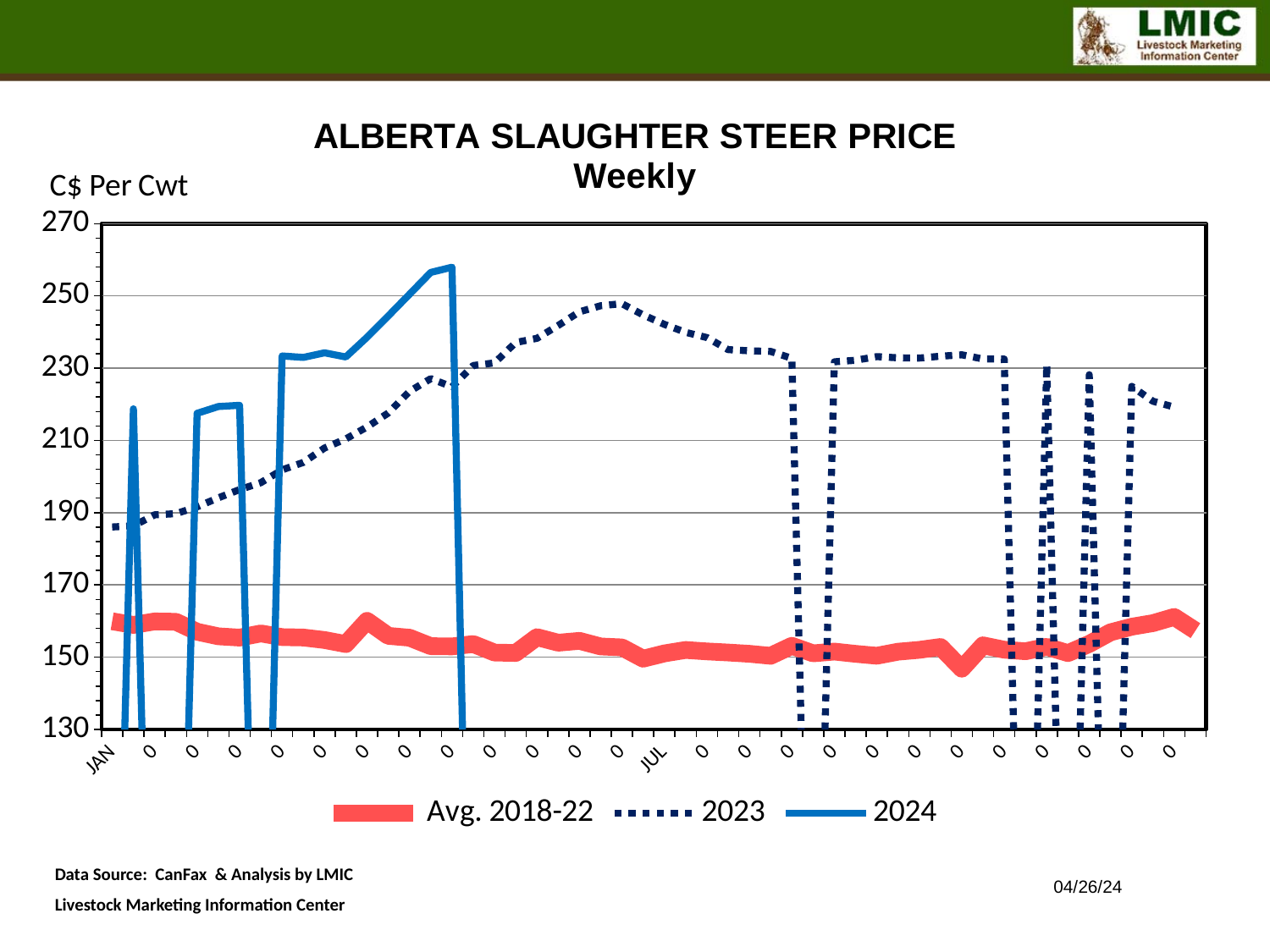
At JAN, which is higher: the 2023 line or the Avg. 2018-22 line? 2023 Is the highest point of the 2024 line greater or less than 250? greater Is the Avg. 2018-22 value at JAN greater or less than 170? less How many series does the legend list? 3 Is the 2023 value at JUL greater or less than 230? greater What kind of chart is shown on the slide? line chart Does the 2023 line rise or fall from JAN to JUL? rise Which series reaches the highest value anywhere on the chart? 2024 At JUL, which is higher: the 2023 line or the Avg. 2018-22 line? 2023 What unit is shown on the vertical axis of the chart? C$ Per Cwt What is the title of the chart? ALBERTA SLAUGHTER STEER PRICE Weekly